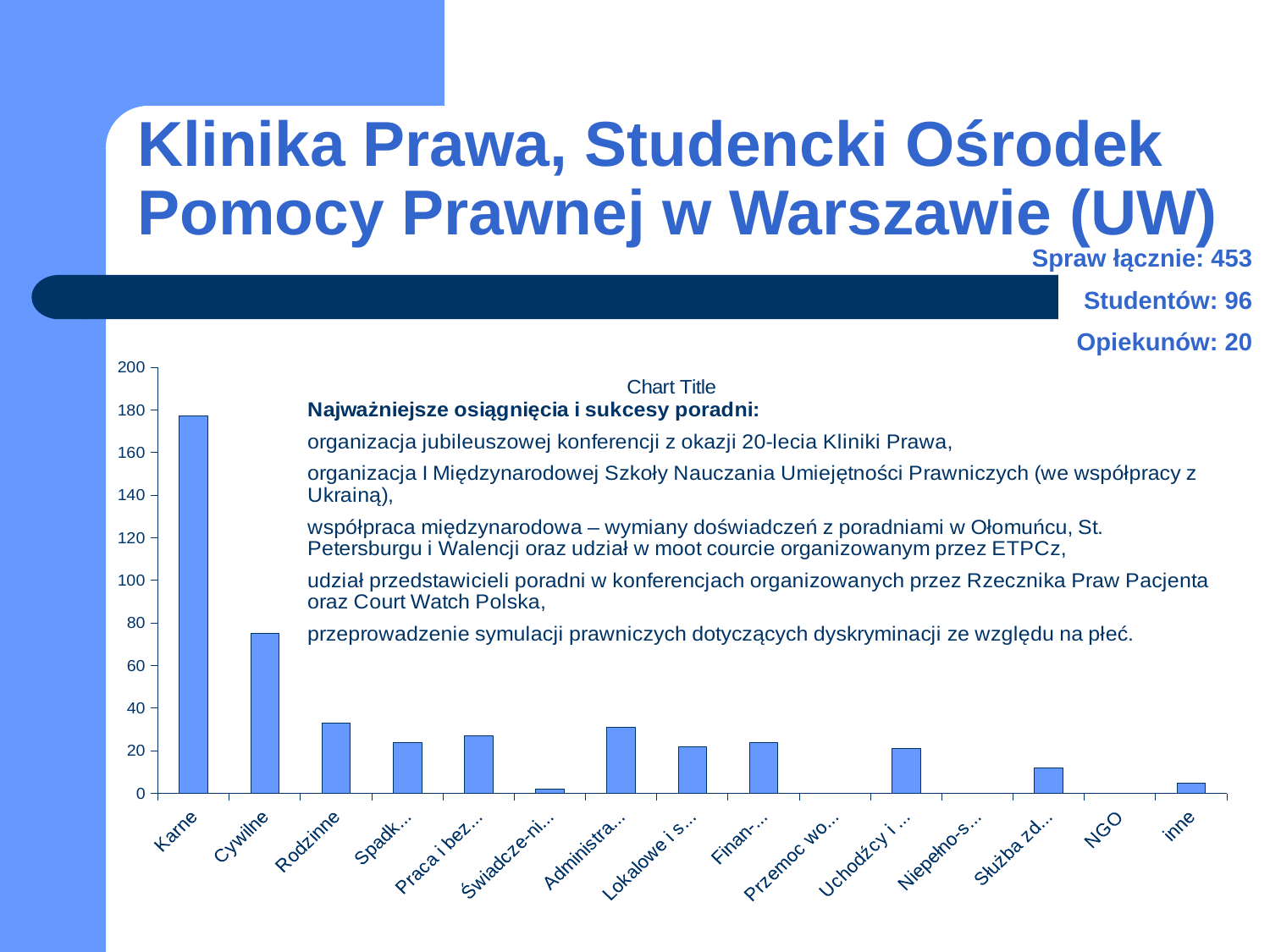
Is the value for Rodzinne greater or less than 40? less Is the value for Administra... greater or less than 20? greater What kind of chart is shown on the slide? bar chart Is the value for Cywilne greater or less than 60? greater Which is larger, the value for Cywilne or the value for Rodzinne? Cywilne How many categories are shown on the x axis of the chart? 15 Which is larger, the value for Karne or the value for Cywilne? Karne What is the title shown on the chart? Chart Title Which category has the highest bar in the chart? Karne